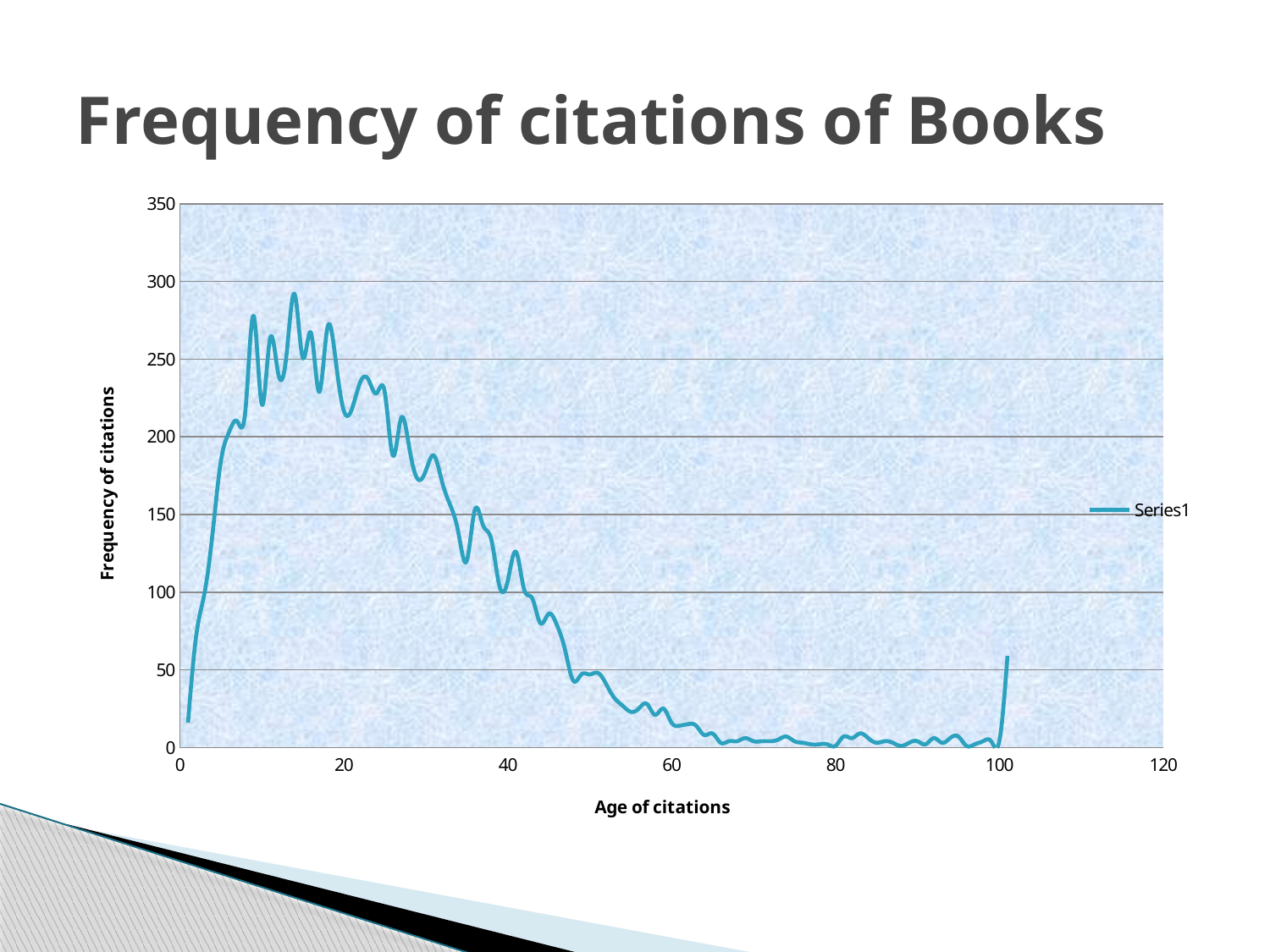
Is the value at an age of citations of 80 greater or less than 50? less Is the highest value of the line greater or less than 250? greater What is the title of the chart? Frequency of citations of Books Is the highest value of the line greater or less than 300? less What is the label of the x axis? Age of citations How many series does the legend list? 1 What kind of chart is shown on the slide? line chart Which is larger, the value at an age of citations of 20 or the value at an age of citations of 60? 20 Between an age of citations of 20 and 60, do the values generally rise or fall? fall